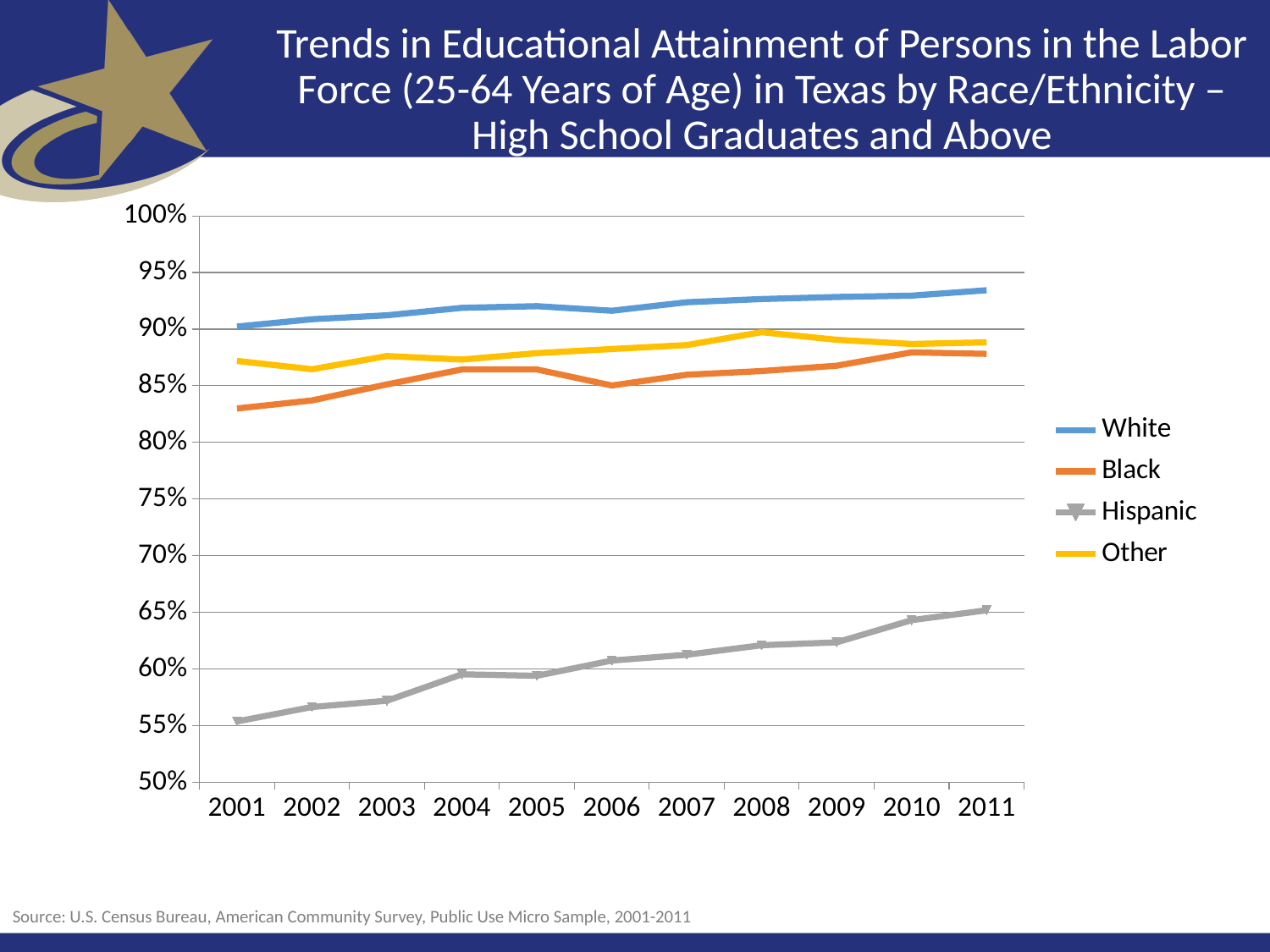
Is the value for White in 2011 greater or less than 90%? greater Which series has the highest values across all years? White In 2001, which is larger: the value for Black or the value for Other? Other What kind of chart is shown on the slide? line chart Which series is drawn in gray with triangle markers? Hispanic Does the Hispanic series generally rise or fall from 2001 to 2011? rise Which series has the lowest values across all years? Hispanic Is the value for Hispanic in 2001 greater or less than 60%? less How many series does the legend list? 4 Is the value for Black in 2001 greater or less than 85%? less How many years are shown on the x axis? 11